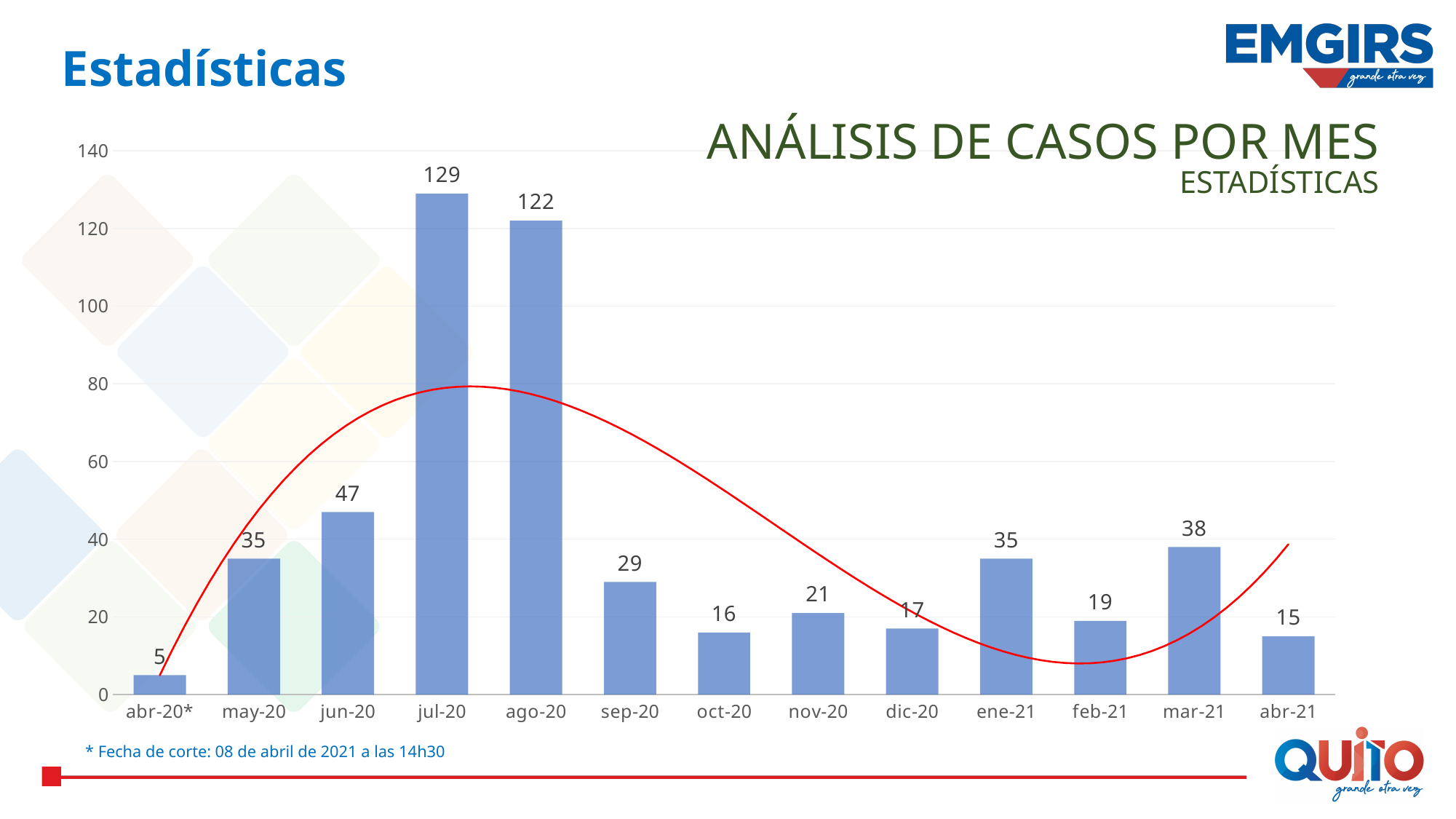
How many months are shown on the x axis? 13 What is the title of the chart? ANÁLISIS DE CASOS POR MES What is the difference between the values for jul-20 and ago-20? 7 Do the values rise or fall from sep-20 to oct-20? fall Which month has the highest value? jul-20 What is the value for ene-21? 35 What is the value for jul-20? 129 What kind of chart is this? bar chart Is the value for jun-20 greater or less than 40? greater What is the value for abr-21? 15 Which month has the lowest value? abr-20* Which is larger, the value for mar-21 or the value for feb-21? mar-21